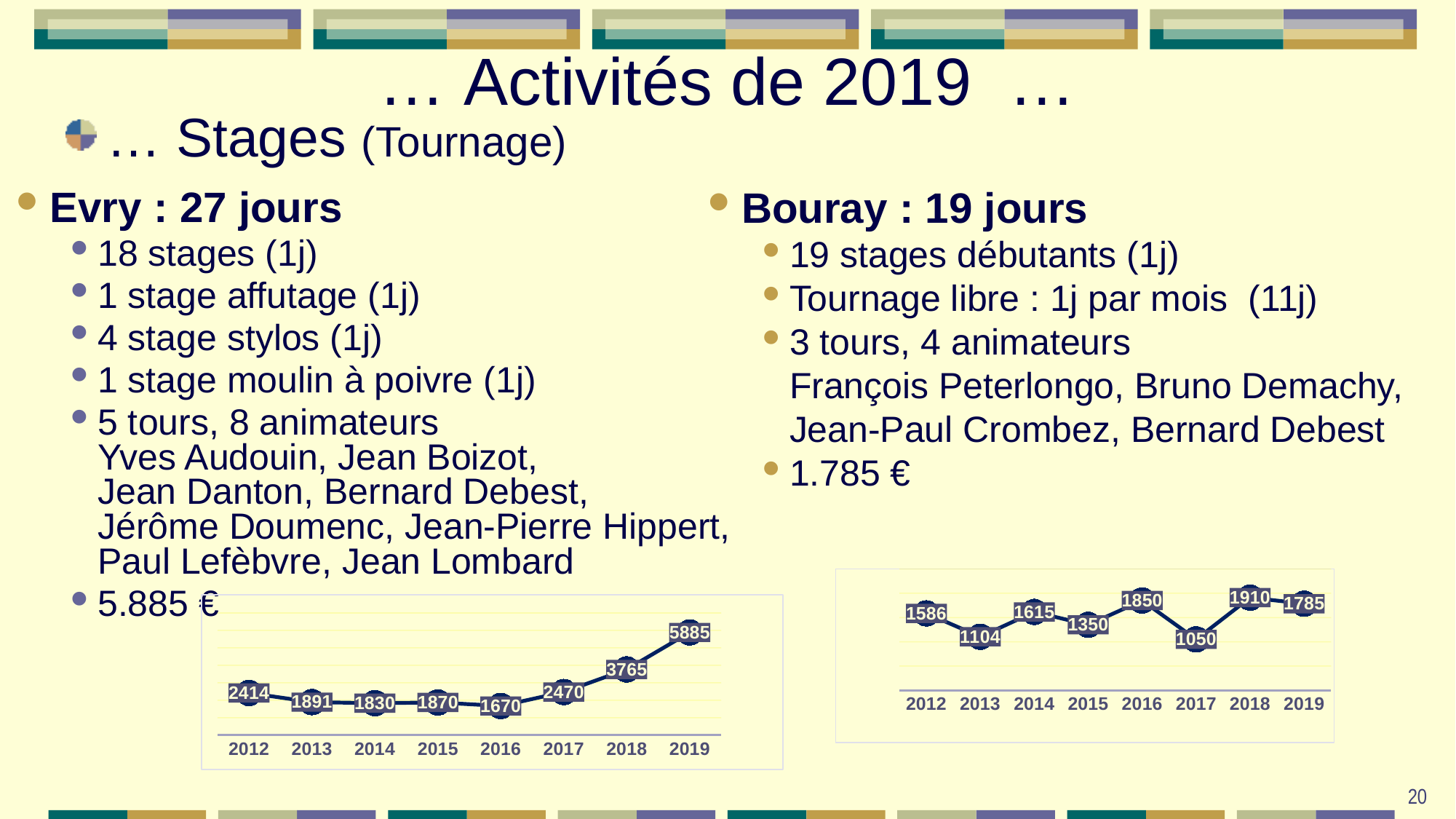
What kind of chart is the left chart? line chart In the left chart, how many years are plotted? 8 In the right chart, what is the difference between the values for 2018 and 2019? 125 In the left chart, which year has the lowest value? 2016 In the left chart, what is the value for 2016? 1670 In the left chart, which year has the highest value? 2019 In the right chart, which is larger, the value for 2014 or the value for 2015? 2014 In the right chart, what is the value for 2017? 1050 In the right chart, which year has the lowest value? 2017 In the left chart, what is the difference between the values for 2019 and 2018? 2120 In the right chart, which year has the highest value? 2018 In the left chart, what is the value for 2019? 5885